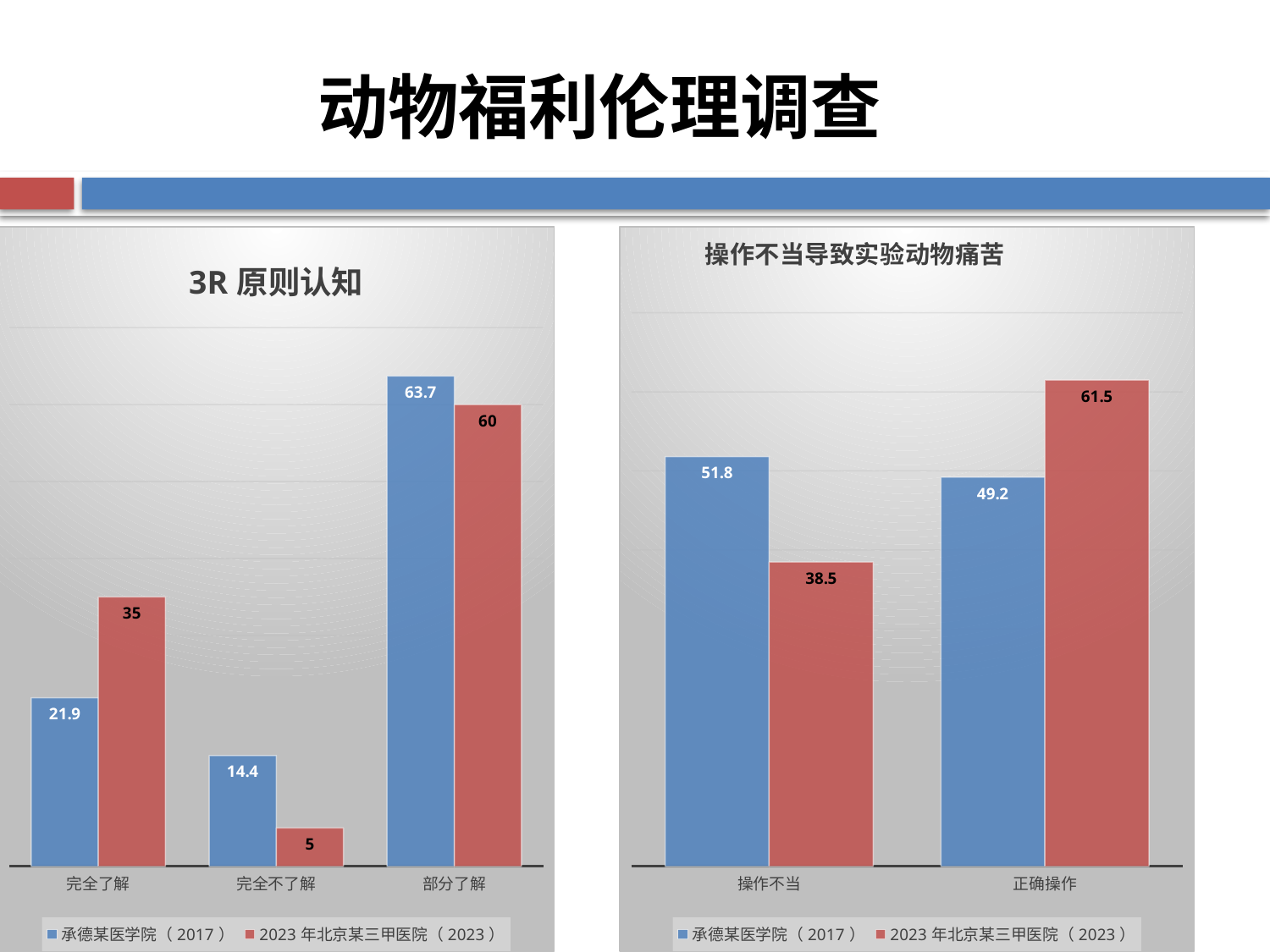
In the '操作不当导致实验动物痛苦' chart, what is the value for 承德某医学院（2017） in the 操作不当 category? 51.8 What kind of chart is the '3R 原则认知' chart? Bar chart In the '3R 原则认知' chart, what is the value for 2023 年北京某三甲医院（2023） in the 完全不了解 category? 5 In the '3R 原则认知' chart, what is the difference between the two series in the 完全了解 category? 13.1 In the '3R 原则认知' chart, which series has the larger value in the 部分了解 category? 承德某医学院（2017） In the '3R 原则认知' chart, how many categories are shown on the x axis? 3 In the '操作不当导致实验动物痛苦' chart, which series has the lowest value overall? 2023 年北京某三甲医院（2023） In the '3R 原则认知' chart, which category has the highest value for 承德某医学院（2017）? 部分了解 How many series does the legend of the '操作不当导致实验动物痛苦' chart list? 2 In the '操作不当导致实验动物痛苦' chart, what is the difference between the two series in the 操作不当 category? 13.3 In the '3R 原则认知' chart, what is the value for 承德某医学院（2017） in the 完全了解 category? 21.9 In the '操作不当导致实验动物痛苦' chart, what is the value for 2023 年北京某三甲医院（2023） in the 正确操作 category? 61.5